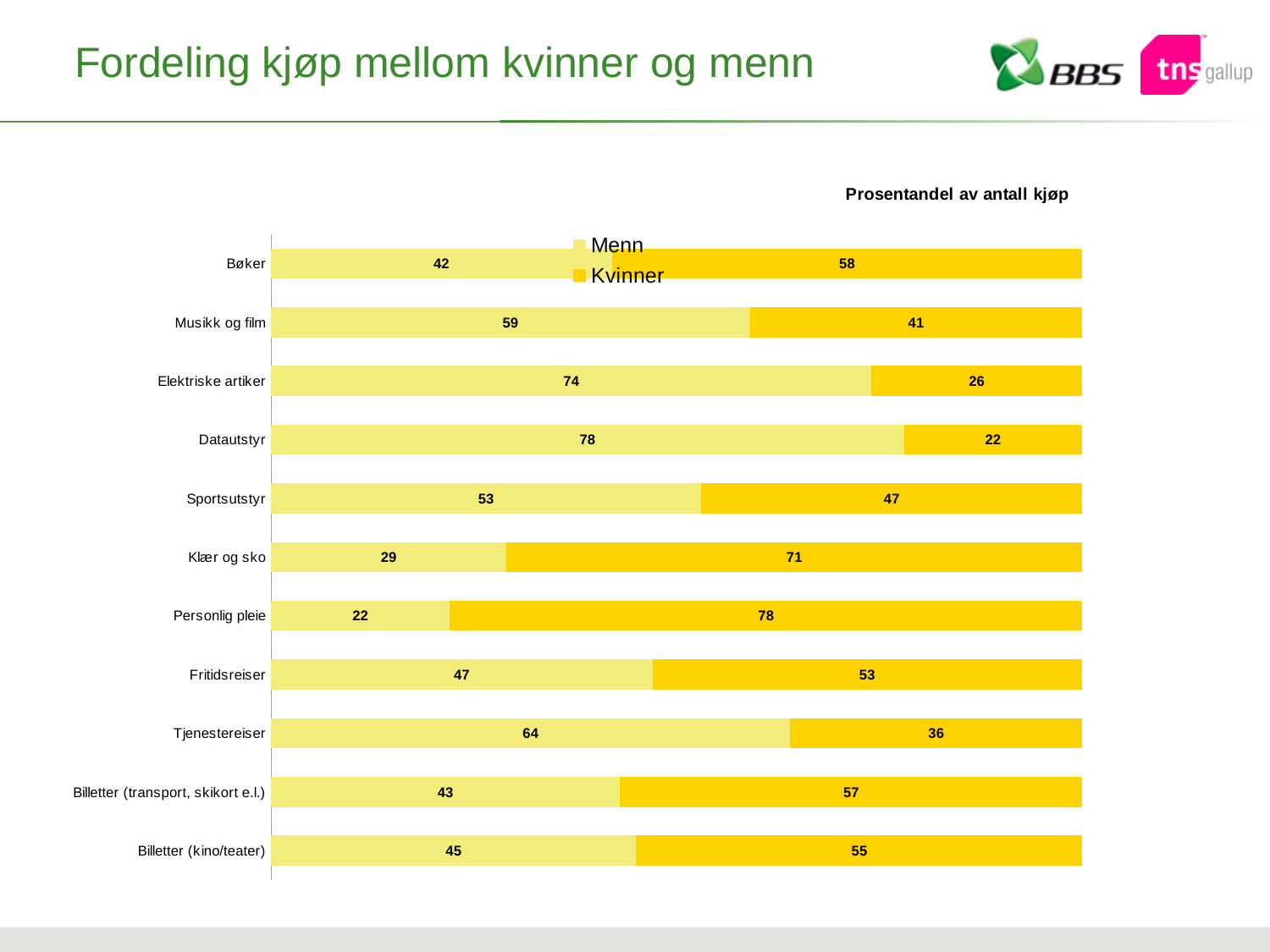
What is the Menn value for Billetter (kino/teater)? 45 Which category has the lowest Kvinner value? Datautstyr For Tjenestereiser, which is larger: the Menn value or the Kvinner value? Menn Which category has the highest Menn value? Datautstyr What kind of chart is shown on the slide? Stacked bar chart How many series does the legend list? 2 What is the title of the chart? Prosentandel av antall kjøp How many categories are shown on the chart? 11 What is the Menn value for Datautstyr? 78 What is the Kvinner value for Klær og sko? 71 What is the total of the stacked bar for Fritidsreiser? 100 What is the difference between the Kvinner and Menn values for Personlig pleie? 56